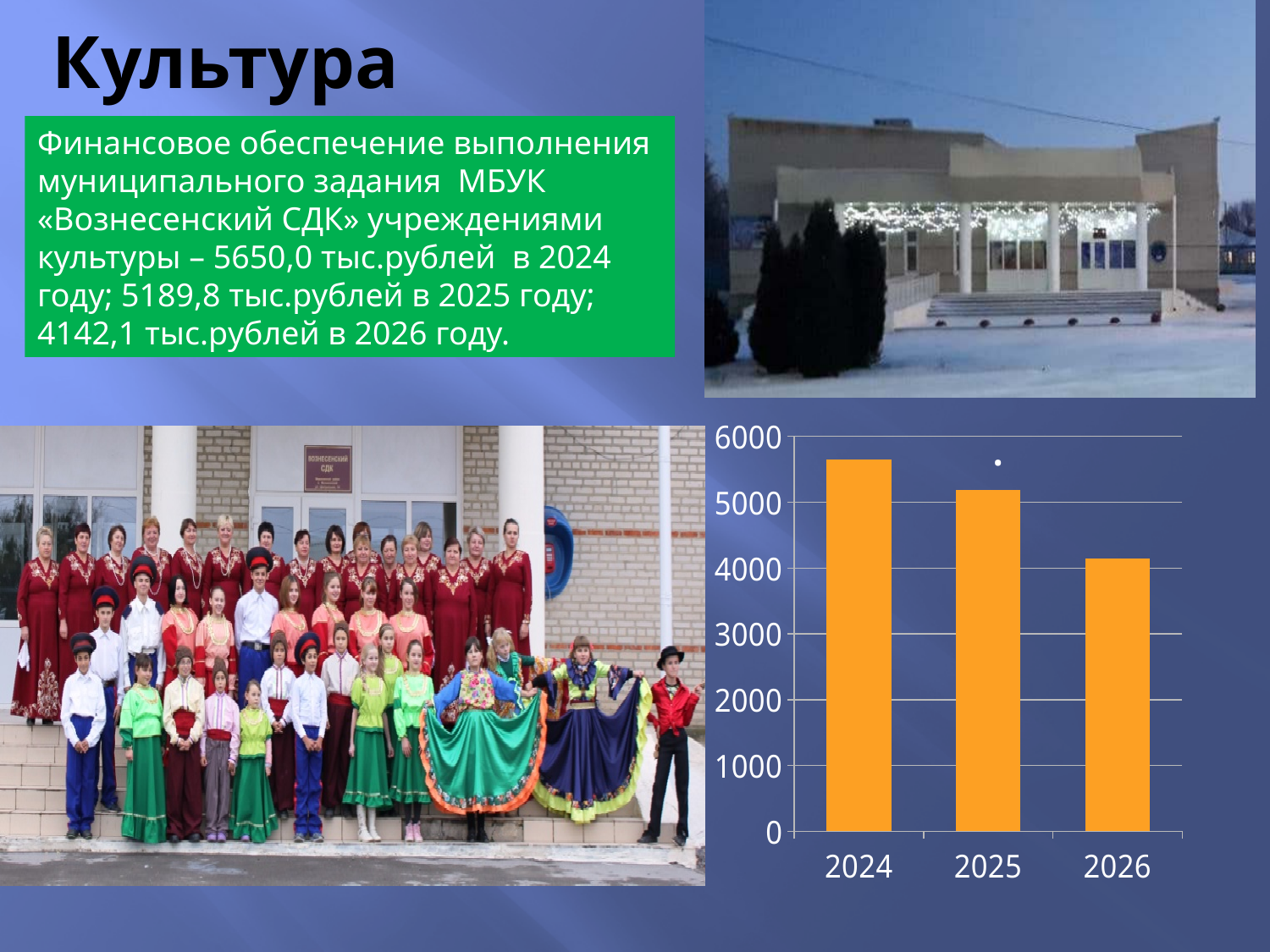
Do the values rise or fall from 2024 to 2026? fall What kind of chart is shown on the slide? bar chart Which is larger, the value for 2024 or the value for 2025? 2024 How many bars does the chart have? 3 Which year has the lowest bar in the chart? 2026 Is the value for 2026 greater or less than 4000? greater What colour are the bars in the chart? orange Which year has the highest bar in the chart? 2024 Is the value for 2024 greater or less than 5000? greater What is the highest tick value shown on the vertical axis of the chart? 6000 Is the value for 2026 greater or less than 5000? less